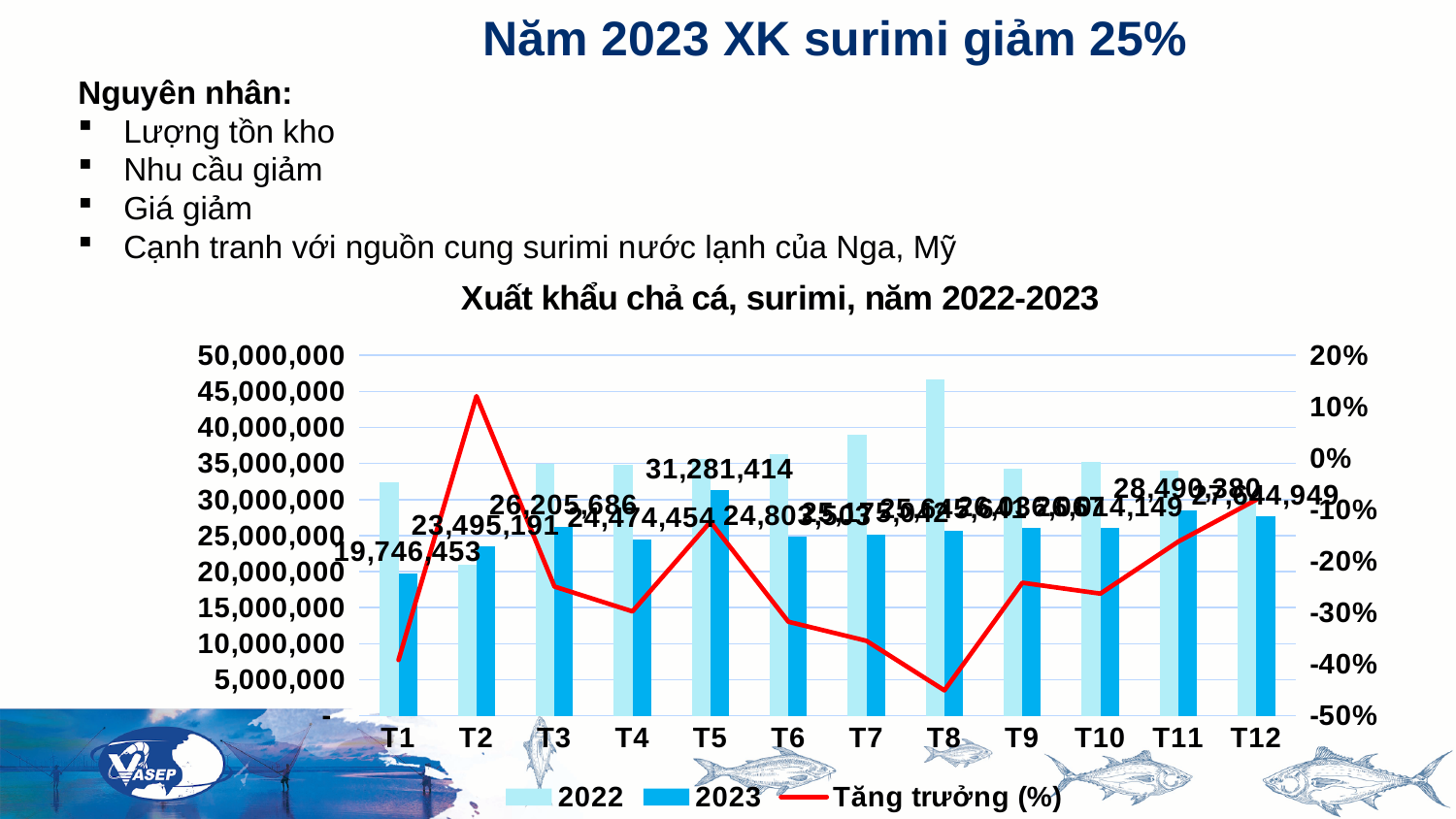
In which month is the 2022 bar highest? T8 Is the Tăng trưởng (%) value for T8 greater or less than -40%? less How many series does the chart legend list? 3 How many months (categories) are shown on the x axis of the chart? 12 What is the difference between the 2023 values for T5 and T1? 11,534,961 In which month is the 2023 value lowest? T1 What is the 2023 value for T1? 19,746,453 What is the 2023 value for T5? 31,281,414 In which month is the 2023 value highest? T5 What is the 2023 value for T11? 28,490,380 For T8, which is larger: the 2022 value or the 2023 value? 2022 What is the title of the chart? Xuất khẩu chả cá, surimi, năm 2022-2023